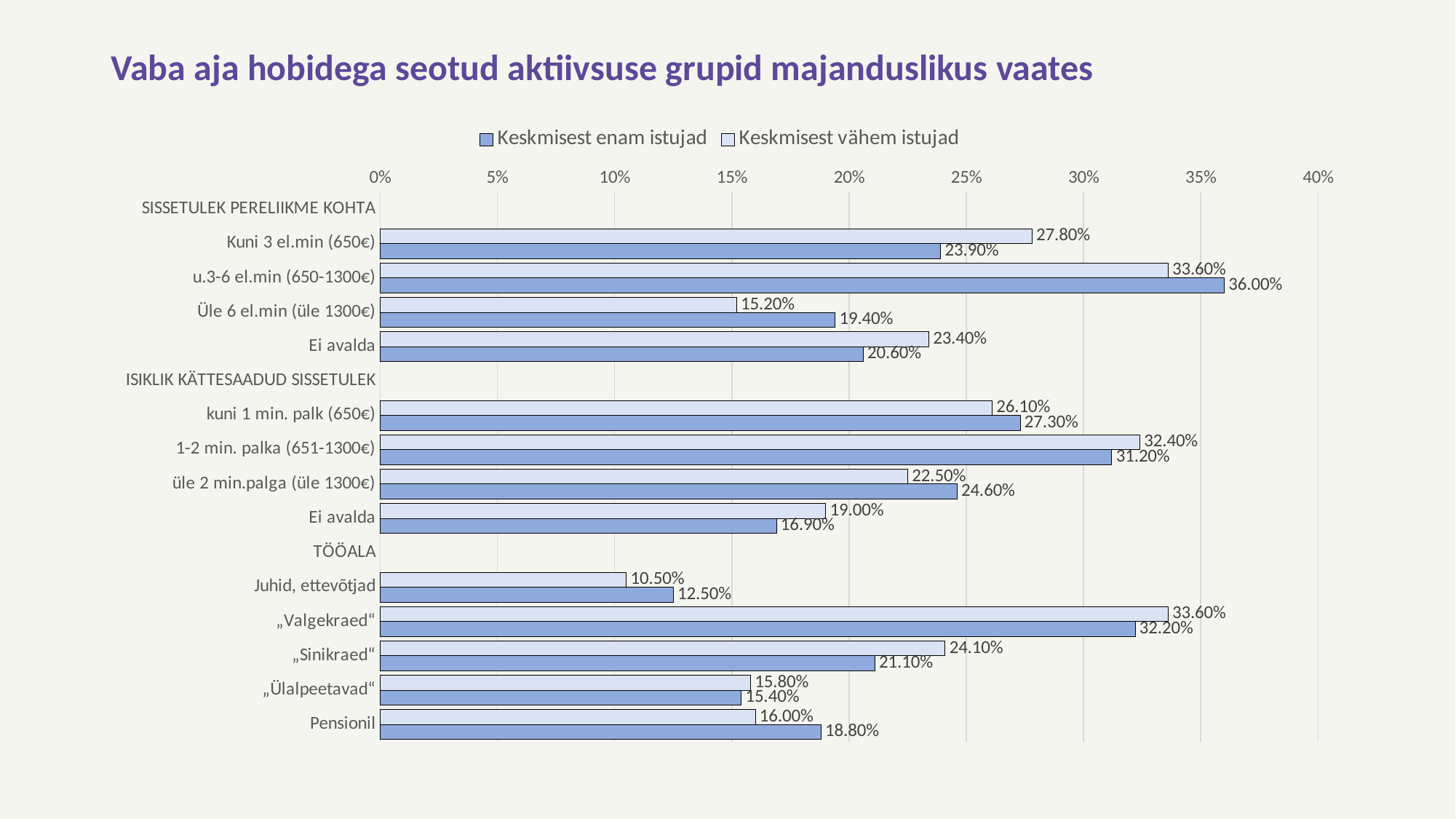
Is the value for "Keskmisest enam istujad" in "„Valgekraed“" greater or less than 30%? greater What is the value for "Keskmisest enam istujad" in the category "u.3-6 el.min (650-1300€)"? 36.00% How many series does the legend list? 2 What is the difference between the "Keskmisest vähem istujad" and "Keskmisest enam istujad" values for "Kuni 3 el.min (650€)"? 3.90% What is the value for "Keskmisest enam istujad" in the category "Pensionil"? 18.80% Which category has the highest value for "Keskmisest enam istujad"? u.3-6 el.min (650-1300€) Which category has the lowest value for "Keskmisest vähem istujad"? Juhid, ettevõtjad What is the difference between the "Keskmisest enam istujad" and "Keskmisest vähem istujad" values for "Üle 6 el.min (üle 1300€)"? 4.20% What is the value for "Keskmisest vähem istujad" in the category "Juhid, ettevõtjad"? 10.50% What is the title of the chart? Vaba aja hobidega seotud aktiivsuse grupid majanduslikus vaates What kind of chart is shown on the slide? bar chart For "„Sinikraed“", which series has the larger value: "Keskmisest enam istujad" or "Keskmisest vähem istujad"? Keskmisest vähem istujad